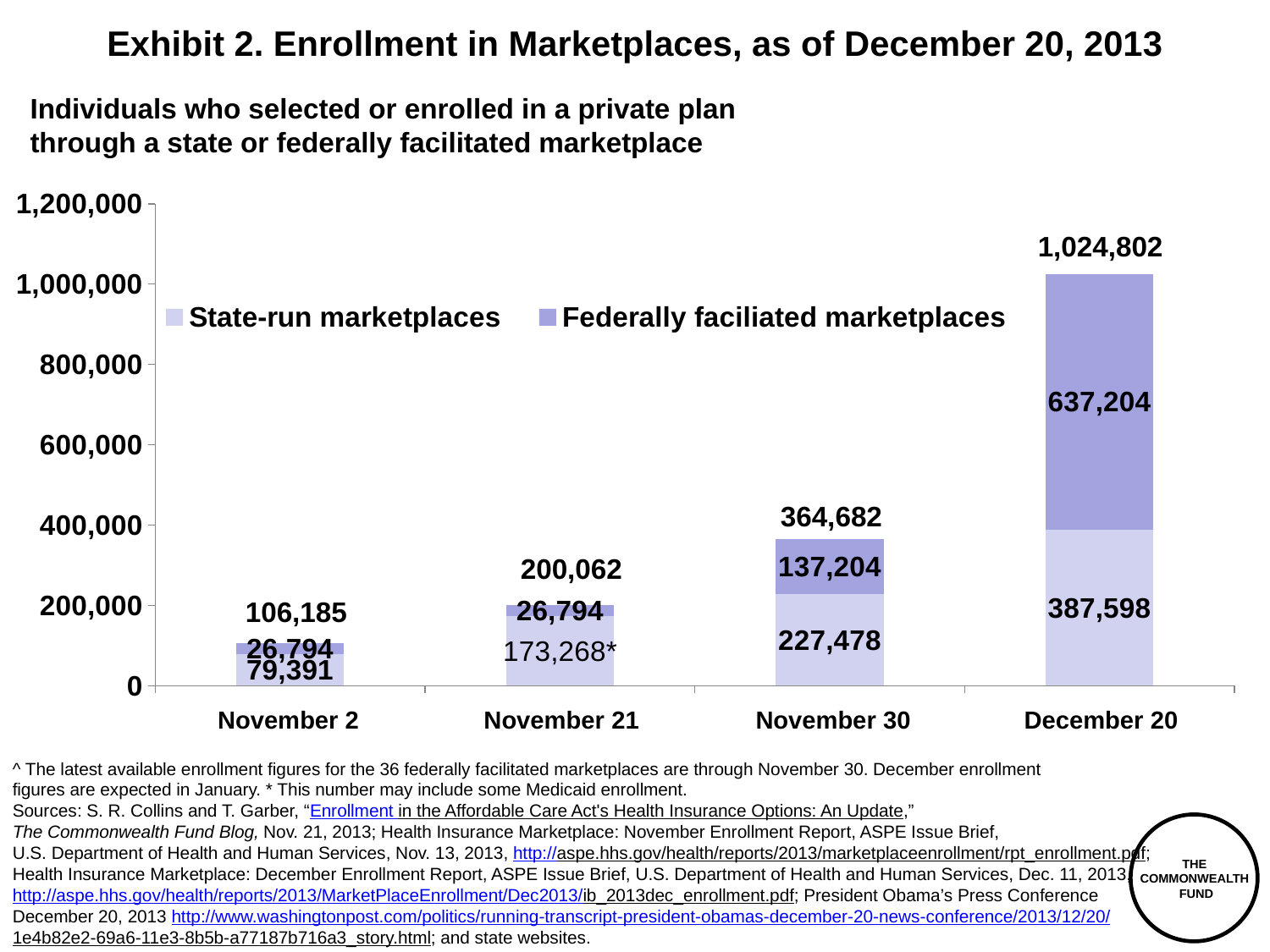
How many series does the legend list? 2 What is the value for State-run marketplaces on November 2? 79,391 What is the total enrollment shown for December 20? 1,024,802 Do the total enrollment values rise or fall from November 2 to December 20? Rise On December 20, which is larger: State-run marketplaces or Federally facilitated marketplaces? Federally facilitated marketplaces Which date has the highest total enrollment? December 20 How many dates are shown along the x axis? 4 Which date has the lowest total enrollment? November 2 What is the value for State-run marketplaces on November 30? 227,478 What type of chart is shown on the slide? Stacked bar chart What is the difference between the total enrollment on December 20 and on November 30? 660,120 What is the value for Federally facilitated marketplaces on December 20? 637,204